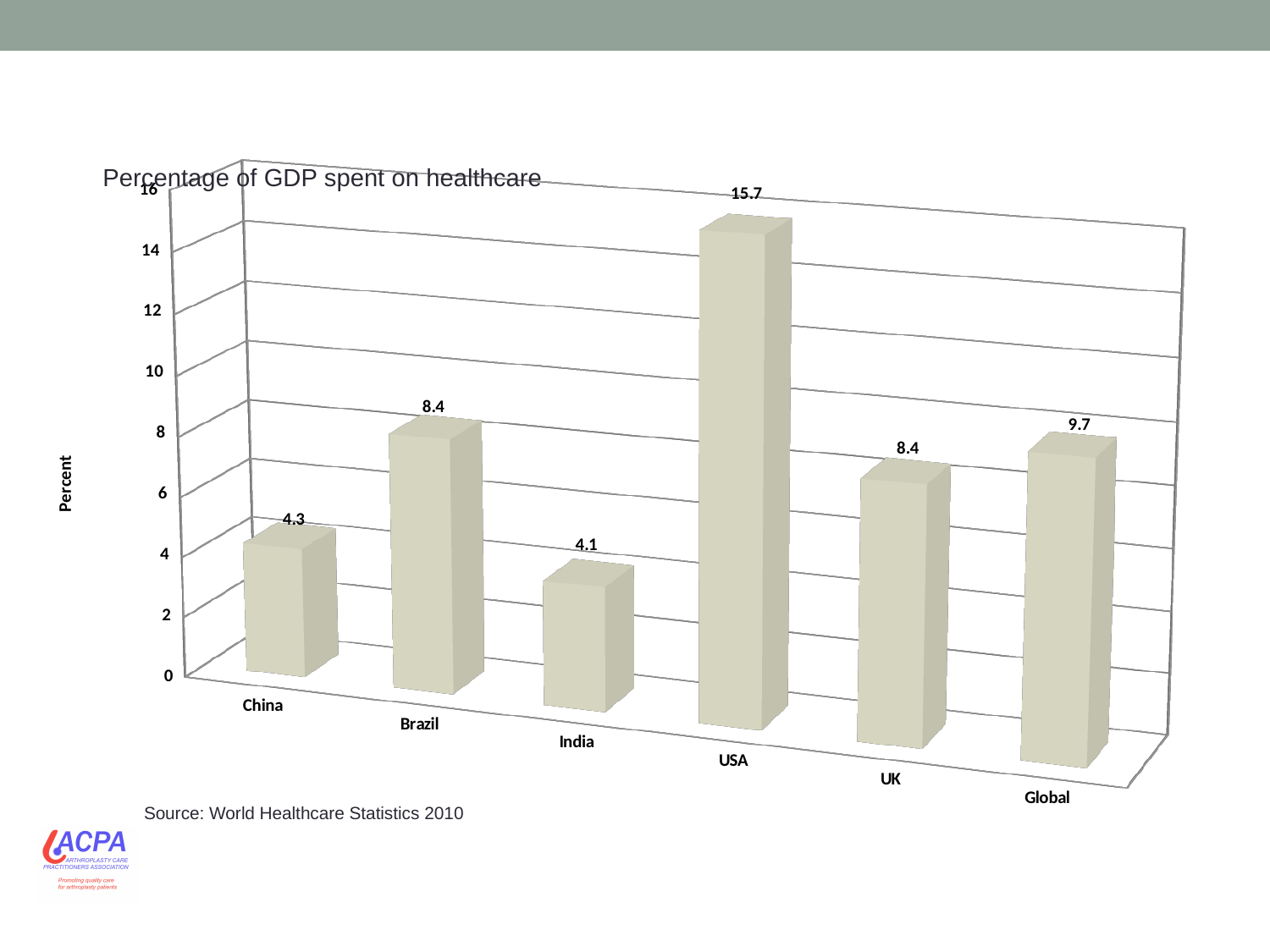
What is the value for Global? 9.7 Which category has the highest value? USA Which category has the lowest value? India What is the value for USA? 15.7 What is the difference between the values for Global and China? 5.4 How many categories are shown on the x axis? 6 Is the value for Global greater or less than 8? greater Which is larger, the value for Brazil or the value for India? Brazil What is the difference between the values for USA and UK? 7.3 What is the value for China? 4.3 What is the title of the chart? Percentage of GDP spent on healthcare What kind of chart is shown? bar chart